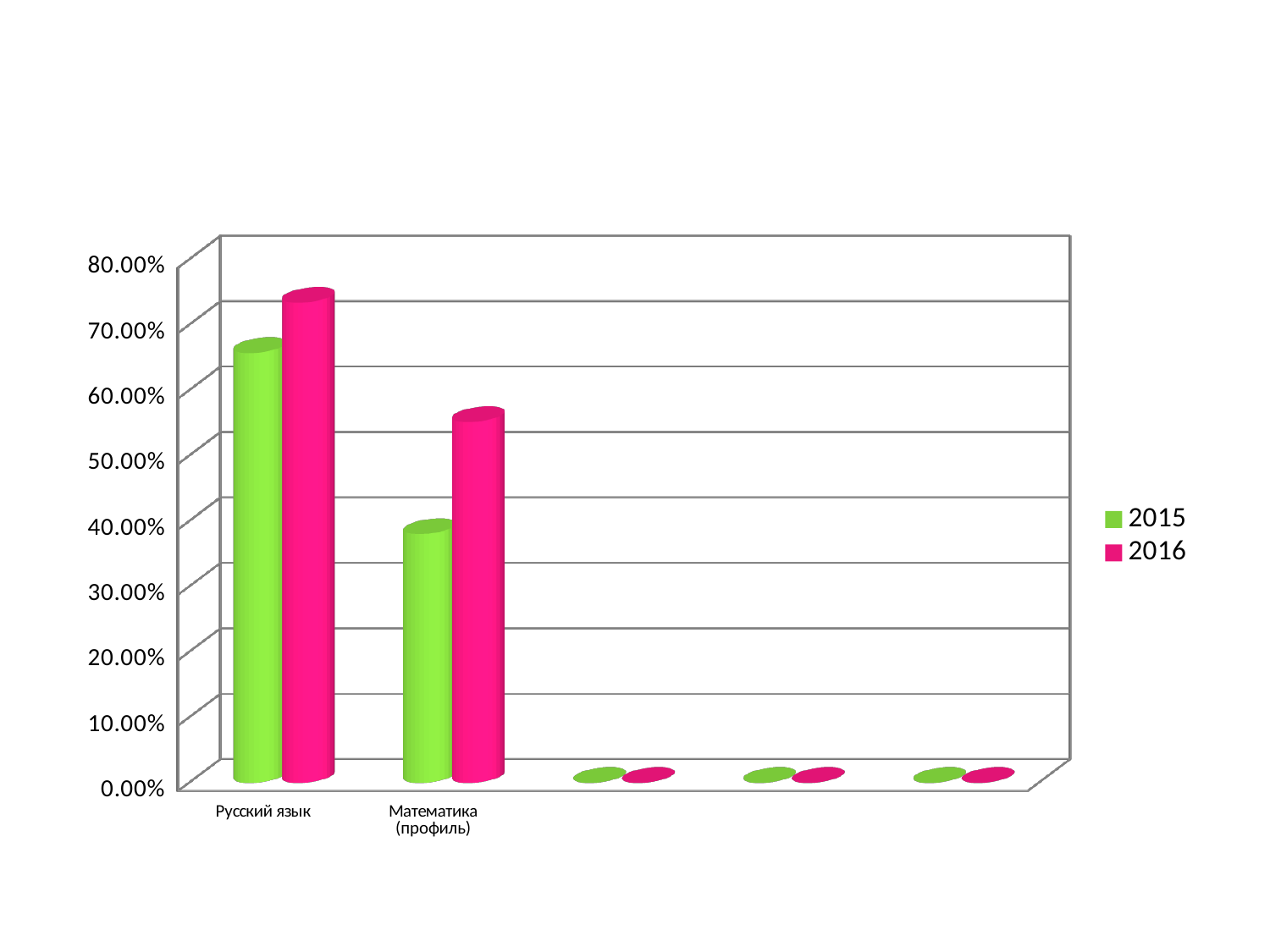
Is the 2015 value for Русский язык greater or less than 60.00%? greater Is the 2016 value for Русский язык greater or less than 70.00%? greater Which series is shown in green in the legend? 2015 What kind of chart is shown on the slide? bar chart Is the 2016 value for Математика (профиль) greater or less than 50.00%? greater For Математика (профиль), which year has the larger value, 2015 or 2016? 2016 Which series is shown in pink in the legend? 2016 For Русский язык, which year has the larger value, 2015 or 2016? 2016 Which category has the highest value for the 2016 series? Русский язык Which category has the highest value for the 2015 series? Русский язык How many series does the legend list? 2